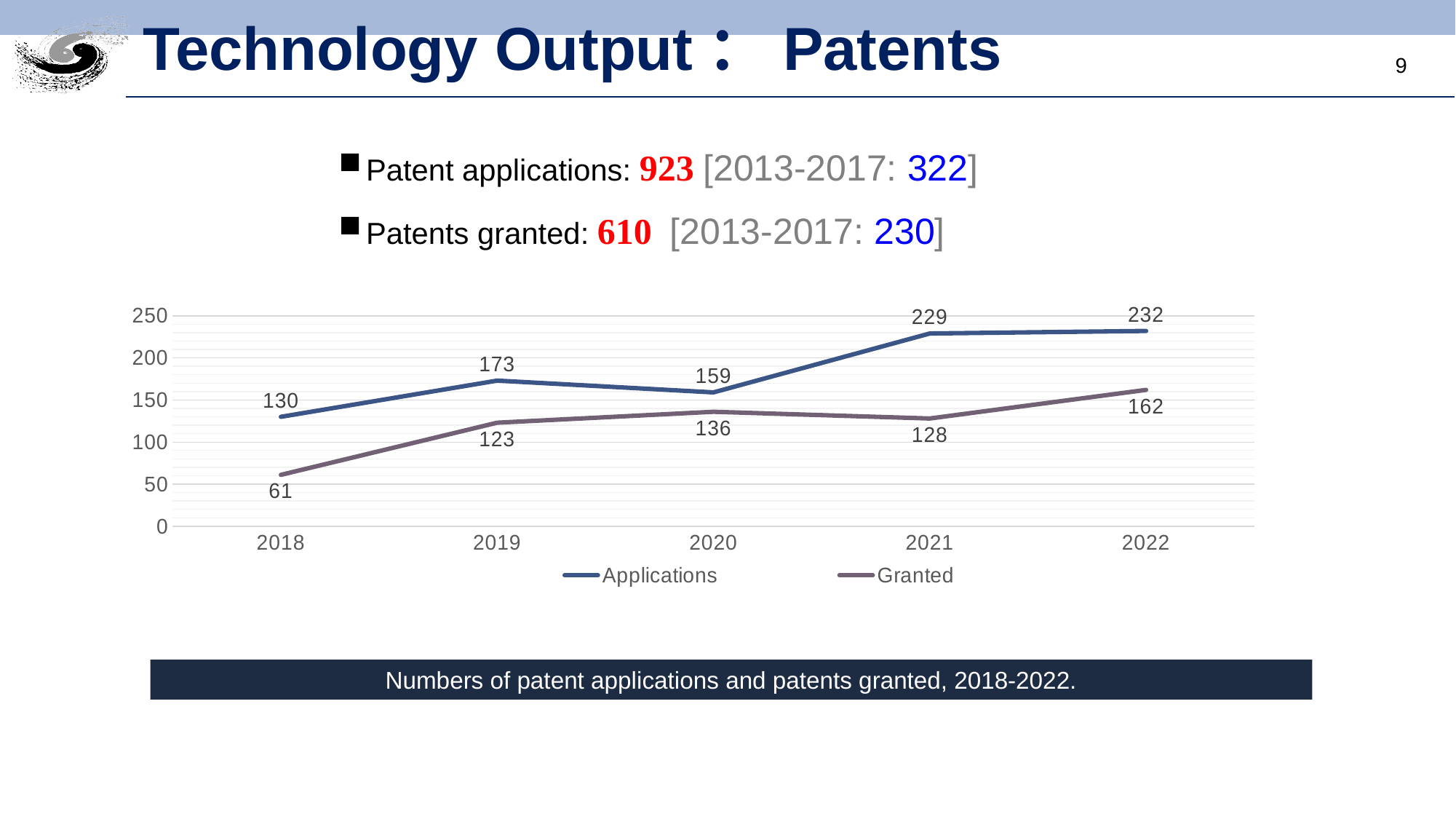
How many series does the chart legend list? 2 Which is larger in 2021, Applications or Granted? Applications What is the value for Granted in 2021? 128 In which year is the Applications value highest? 2022 What is the value for Granted in 2018? 61 What is the difference between Applications and Granted in 2020? 23 What are the two series named in the chart legend? Applications and Granted How many years are plotted on the x axis of the chart? 5 Does the Granted series rise or fall from 2018 to 2019? rise What is the value for Applications in 2019? 173 In which year is the Granted value lowest? 2018 What type of chart is shown on the slide? line chart